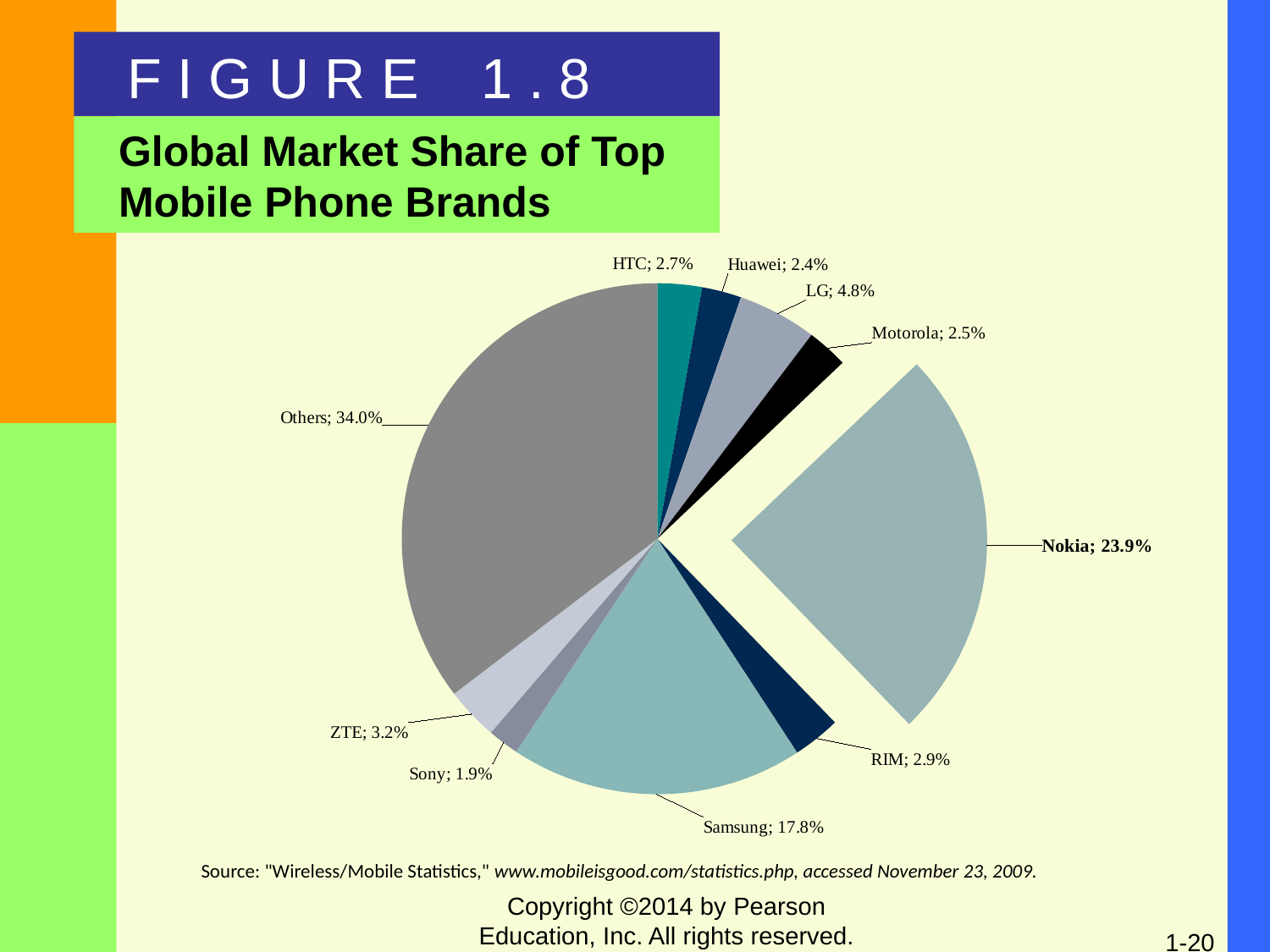
Which named brand has the smallest share in the pie chart? Sony What is the difference between Nokia's share and Samsung's share? 6.1% What share does the chart show for LG? 4.8% Which has a larger share, ZTE or HTC? ZTE How many slices does the pie chart have? 10 What is the share shown for Sony? 1.9% What is Samsung's share in the pie chart? 17.8% What is Nokia's global market share according to the chart? 23.9% What is the title of the chart on the slide? Global Market Share of Top Mobile Phone Brands What kind of chart is shown on the slide? pie chart What is the combined share of Nokia and Samsung? 41.7% Which slice of the pie chart is the largest? Others